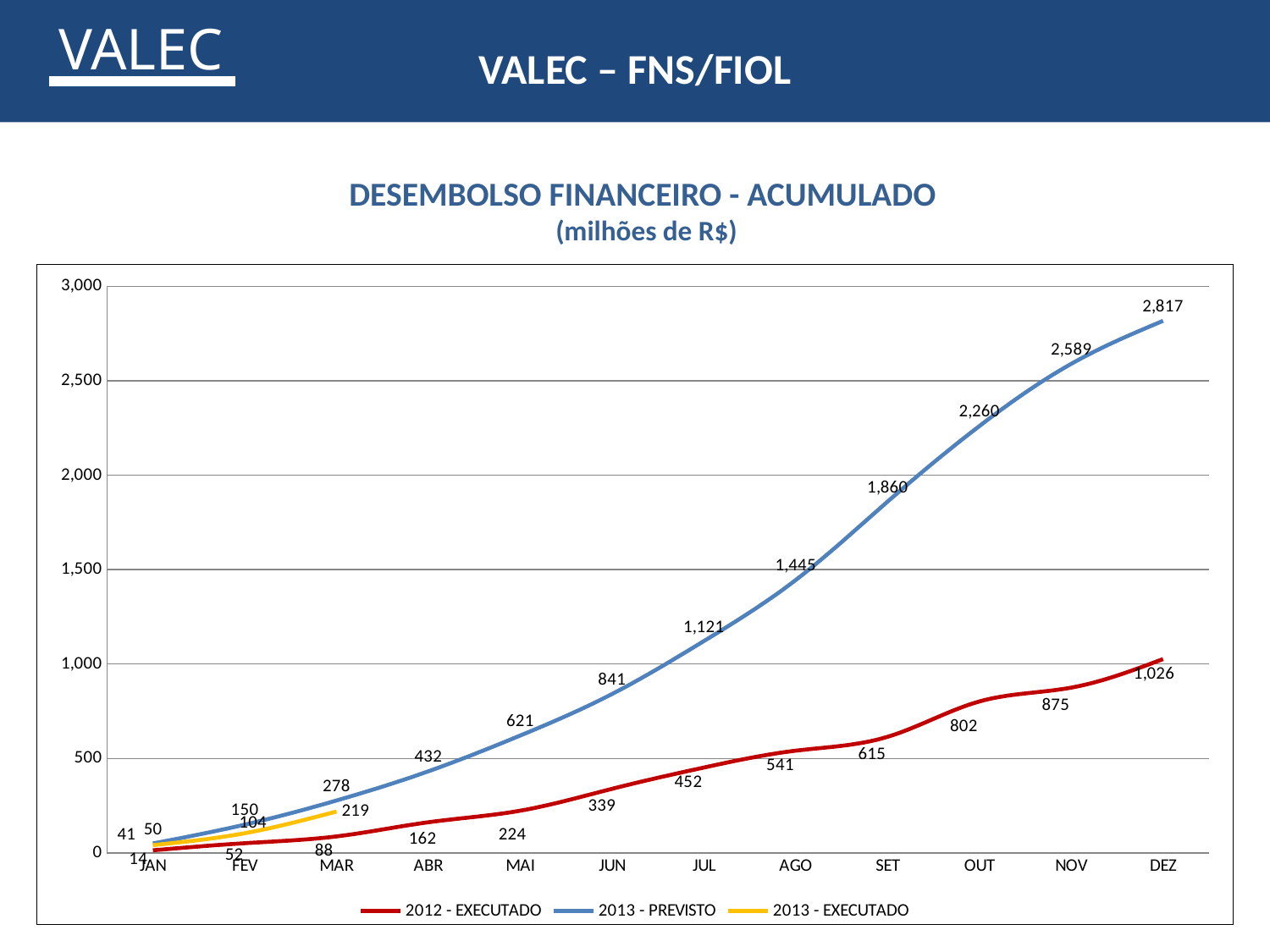
What is the difference between the 2013 - PREVISTO and 2013 - EXECUTADO values in MAR? 59 What is the value of the 2012 - EXECUTADO series in DEZ? 1,026 How many series does the legend list? 3 Does the 2013 - PREVISTO series rise or fall from JAN to DEZ? Rise What is the value of the 2013 - PREVISTO series in JUL? 1,121 What is the value of the 2013 - EXECUTADO series in MAR? 219 What is the value of the 2013 - PREVISTO series in DEZ? 2,817 What kind of chart is shown on the slide? Line chart What is the difference between the 2013 - PREVISTO and 2012 - EXECUTADO values in DEZ? 1,791 In which month does the 2012 - EXECUTADO series reach its highest value? DEZ How many months are shown on the x axis? 12 In MAR, which series has the larger value: 2012 - EXECUTADO or 2013 - EXECUTADO? 2013 - EXECUTADO